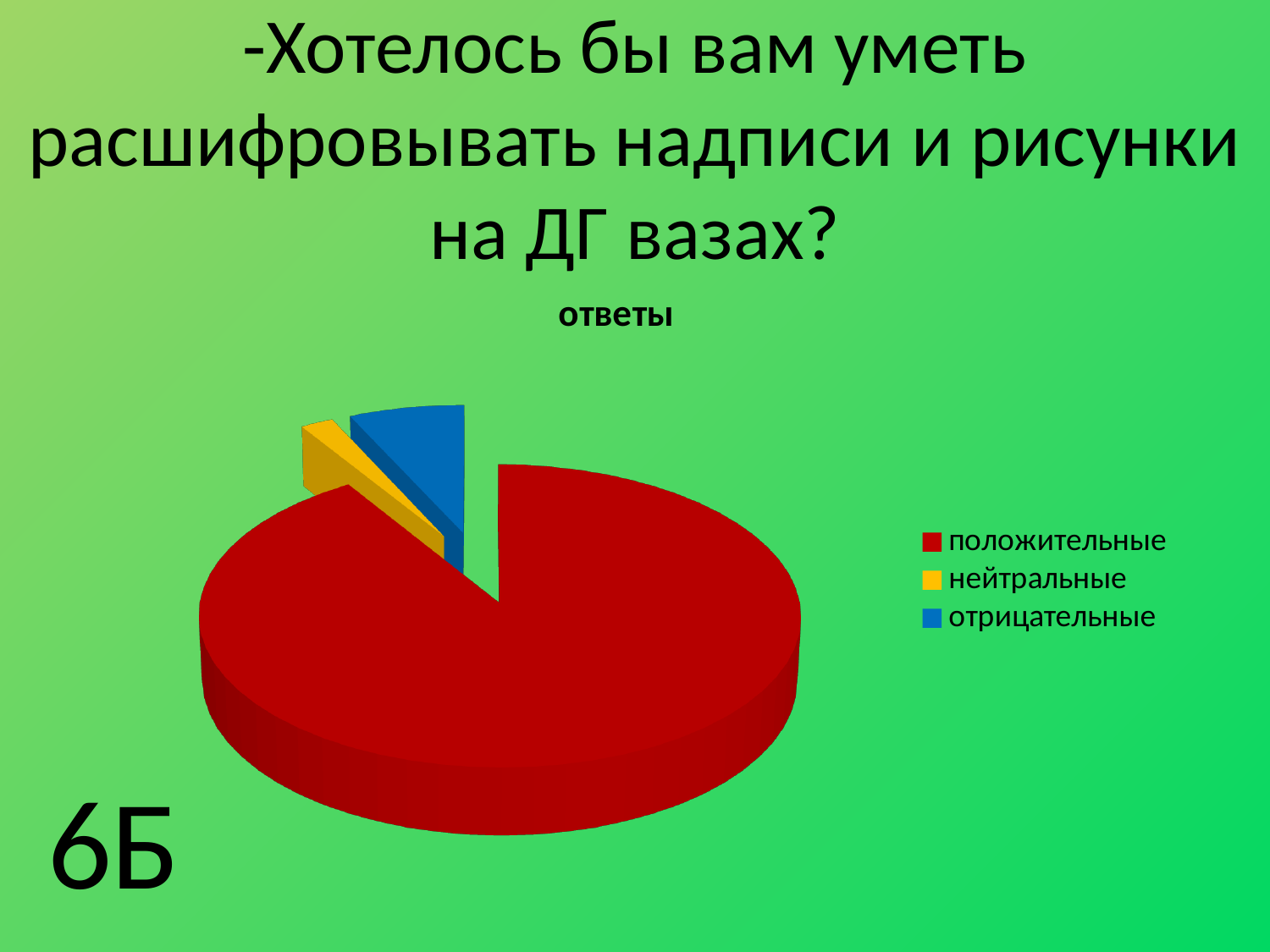
What colour is the slice for нейтральные? yellow Which category is shown in red in the pie chart? положительные Which category is shown in blue in the pie chart? отрицательные Which is larger, the slice for положительные or the slice for отрицательные? положительные How many slices does the pie chart have? 3 What kind of chart is shown on the slide? pie chart Which is larger, the slice for положительные or the slice for нейтральные? положительные How many entries does the chart legend list? 3 Which category has the largest slice of the pie? положительные What is the title of the chart? ответы